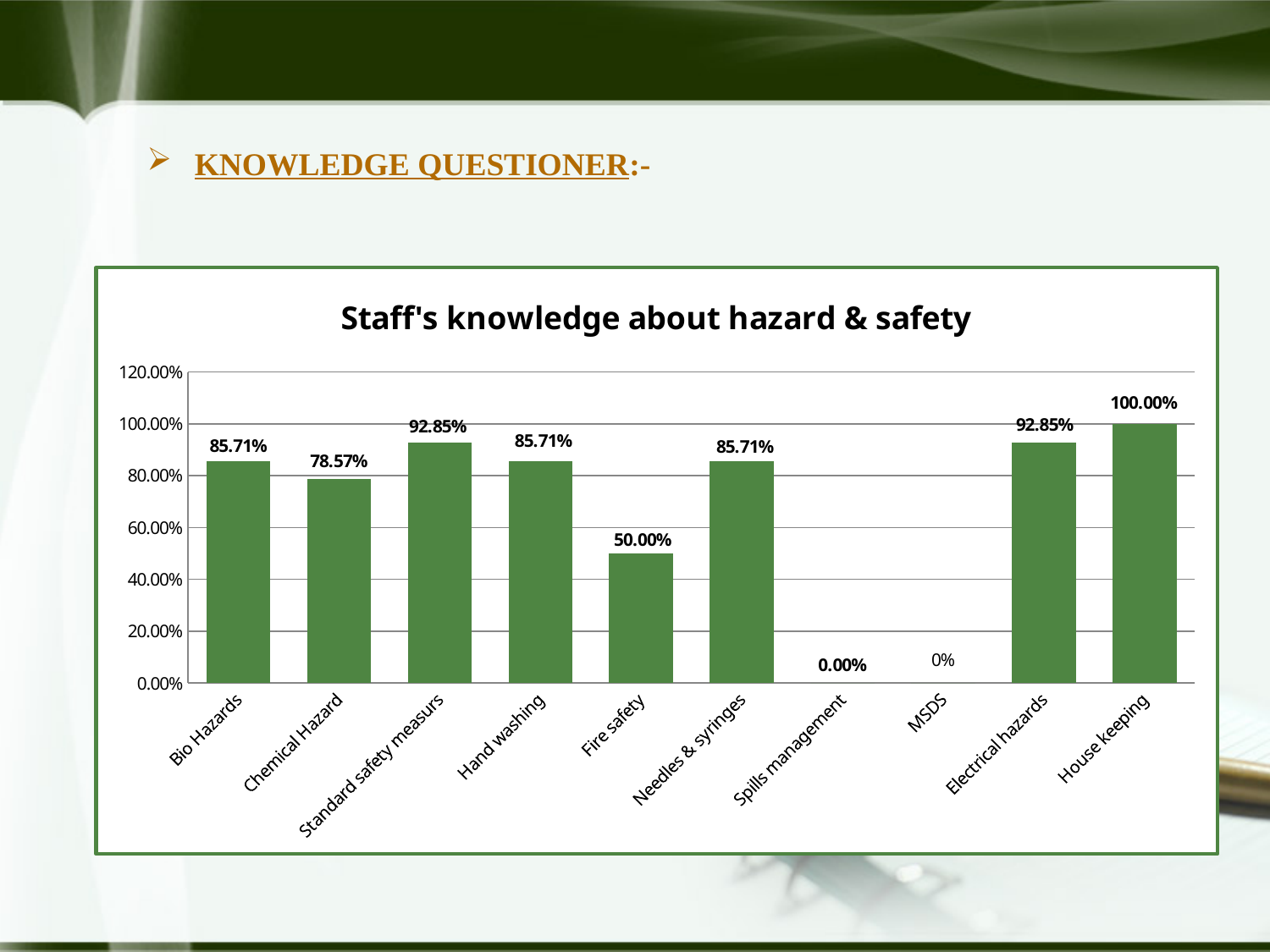
Which category has the highest value? House keeping How many categories are shown on the x axis? 10 What is the value for Chemical Hazard? 78.57% What is the difference between the values for House keeping and Fire safety? 50.00% Which is larger, the value for Hand washing or the value for Chemical Hazard? Hand washing What is the value for Fire safety? 50.00% What is the title of the chart? Staff's knowledge about hazard & safety What is the difference between the values for Standard safety measurs and Chemical Hazard? 14.28% What is the value for Spills management? 0.00% Is the value for Fire safety greater or less than 60.00%? less What is the value for Electrical hazards? 92.85% What kind of chart is this? bar chart